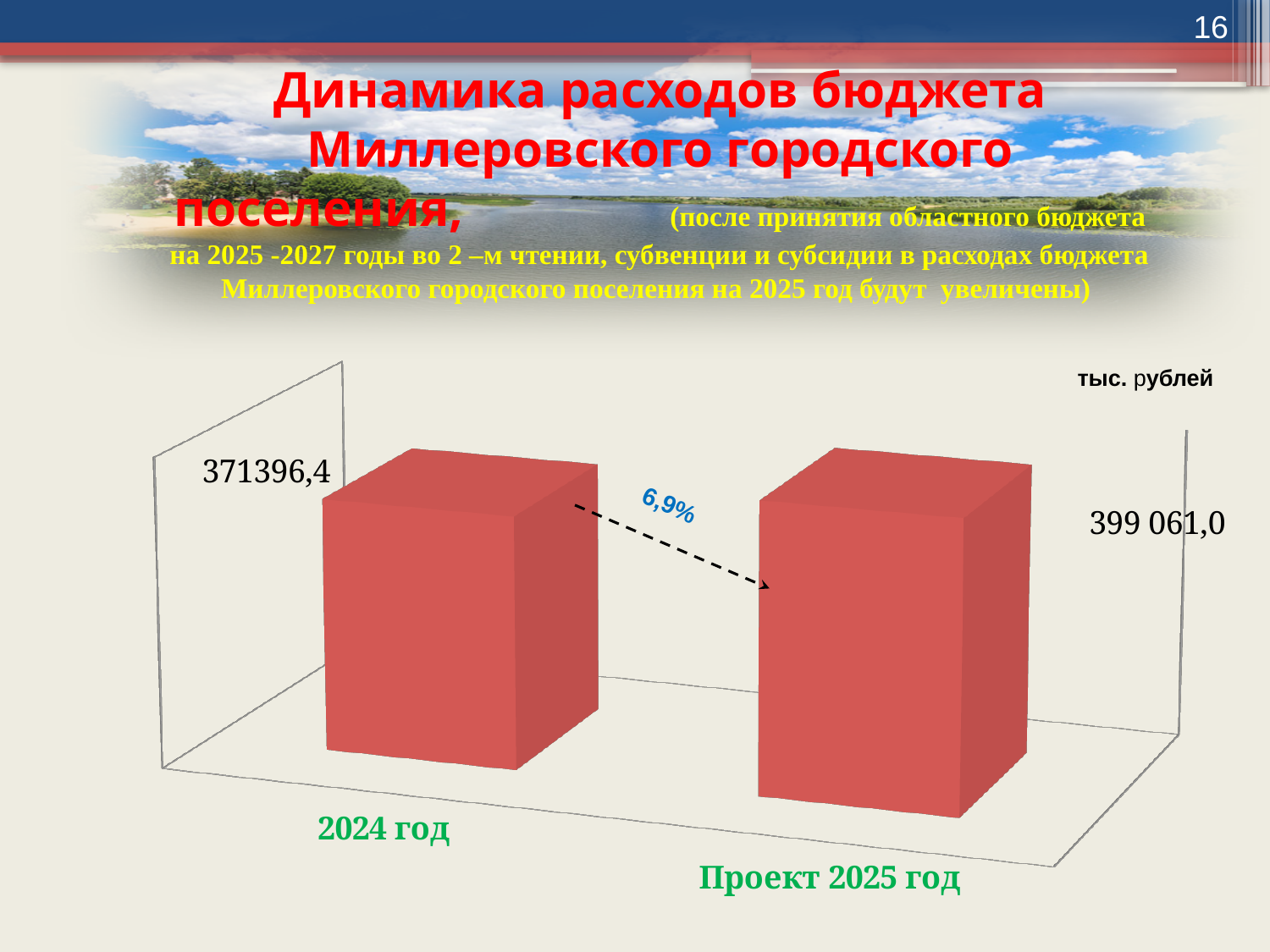
What percentage change is labelled on the arrow between the two bars? 6,9% What is the value for 2024 год? 371396,4 Which category has the lowest value? 2024 год Which category has the highest value? Проект 2025 год What is the value for Проект 2025 год? 399 061,0 How many bars are shown in the chart? 2 Do the values rise or fall from 2024 год to Проект 2025 год? rise What unit of measurement is indicated on the chart? тыс. рублей What kind of chart is shown on the slide? bar chart Which is larger, the value for 2024 год or for Проект 2025 год? Проект 2025 год What is the difference between the value for Проект 2025 год and the value for 2024 год? 27664,6